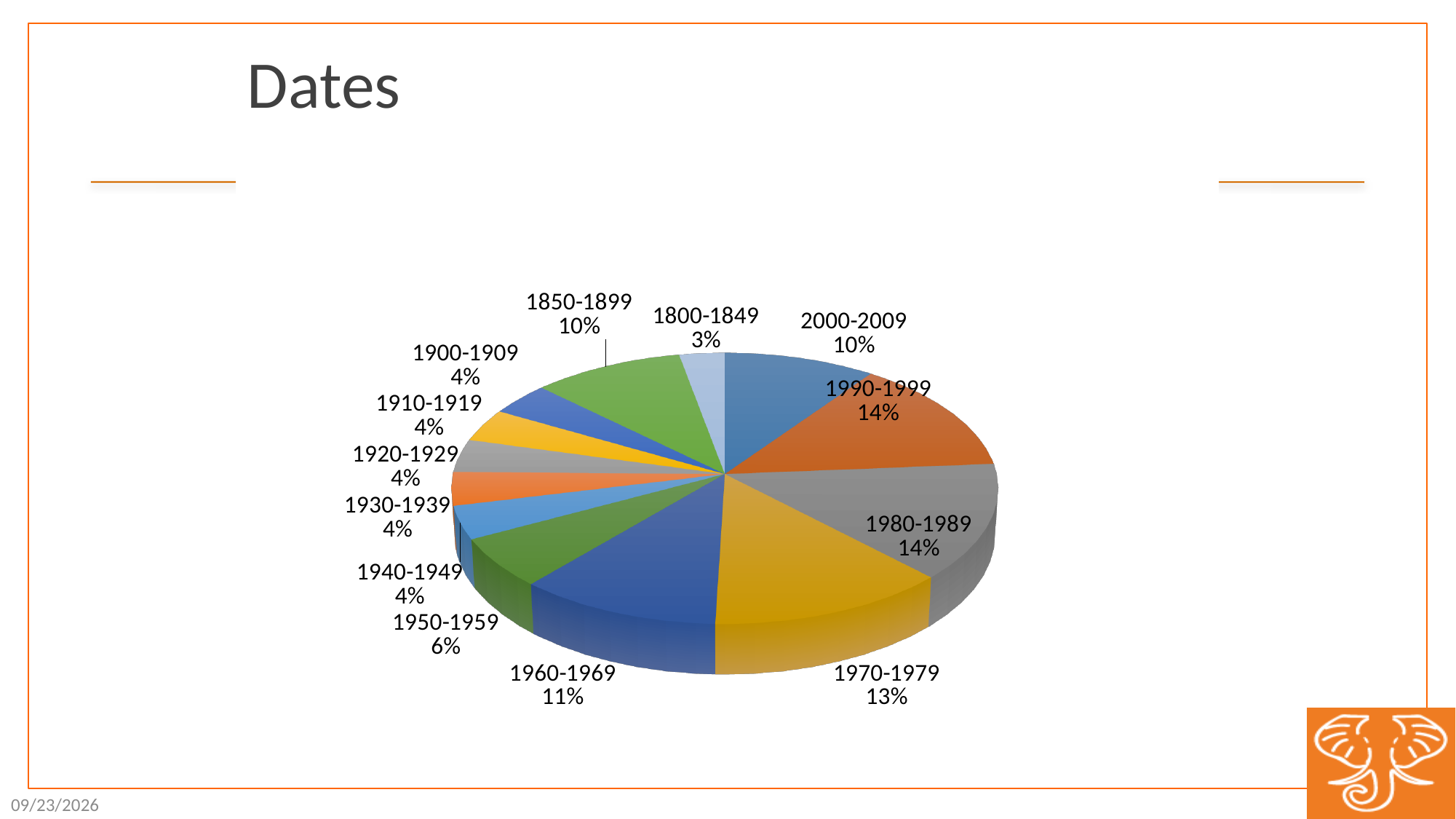
What share of the pie does the 1970-1979 slice represent? 13% What is the value shown for 1950-1959? 6% Which is larger, the value for 1970-1979 or the value for 1960-1969? 1970-1979 What is the value shown for 1960-1969? 11% Which category has the smallest slice of the pie? 1800-1849 What is the title of the chart? Dates What is the difference between the values for 1990-1999 and 1800-1849? 11% What is the value shown for 2000-2009? 10% What kind of chart is shown on the slide? pie chart How many slices does the pie chart have? 13 What is the difference between the values for 1980-1989 and 1950-1959? 8% What is the value shown for 1850-1899? 10%